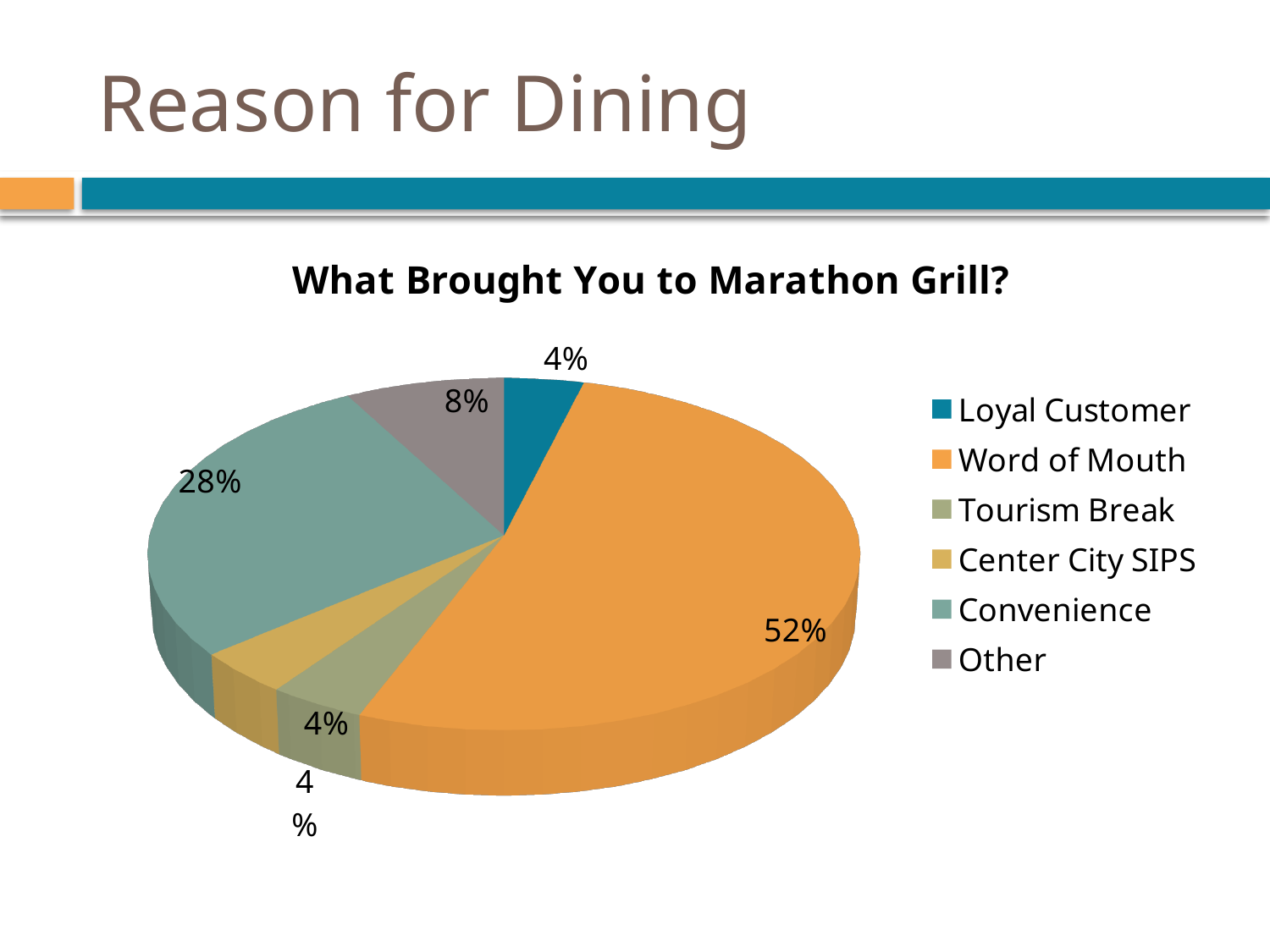
What share of the pie does Loyal Customer represent? 4% What is the title of the chart? What Brought You to Marathon Grill? What is the difference in percentage points between Word of Mouth and Convenience? 24 What kind of chart is shown on the slide? Pie chart Which is larger, the share for Other or the share for Loyal Customer? Other What is the difference in percentage points between Convenience and Other? 20 How many categories does the legend list? 6 Which category has the largest share of the pie? Word of Mouth Which category has the second-largest share of the pie? Convenience What share of the pie does Word of Mouth represent? 52% What share of the pie does Convenience represent? 28% What share of the pie does Other represent? 8%